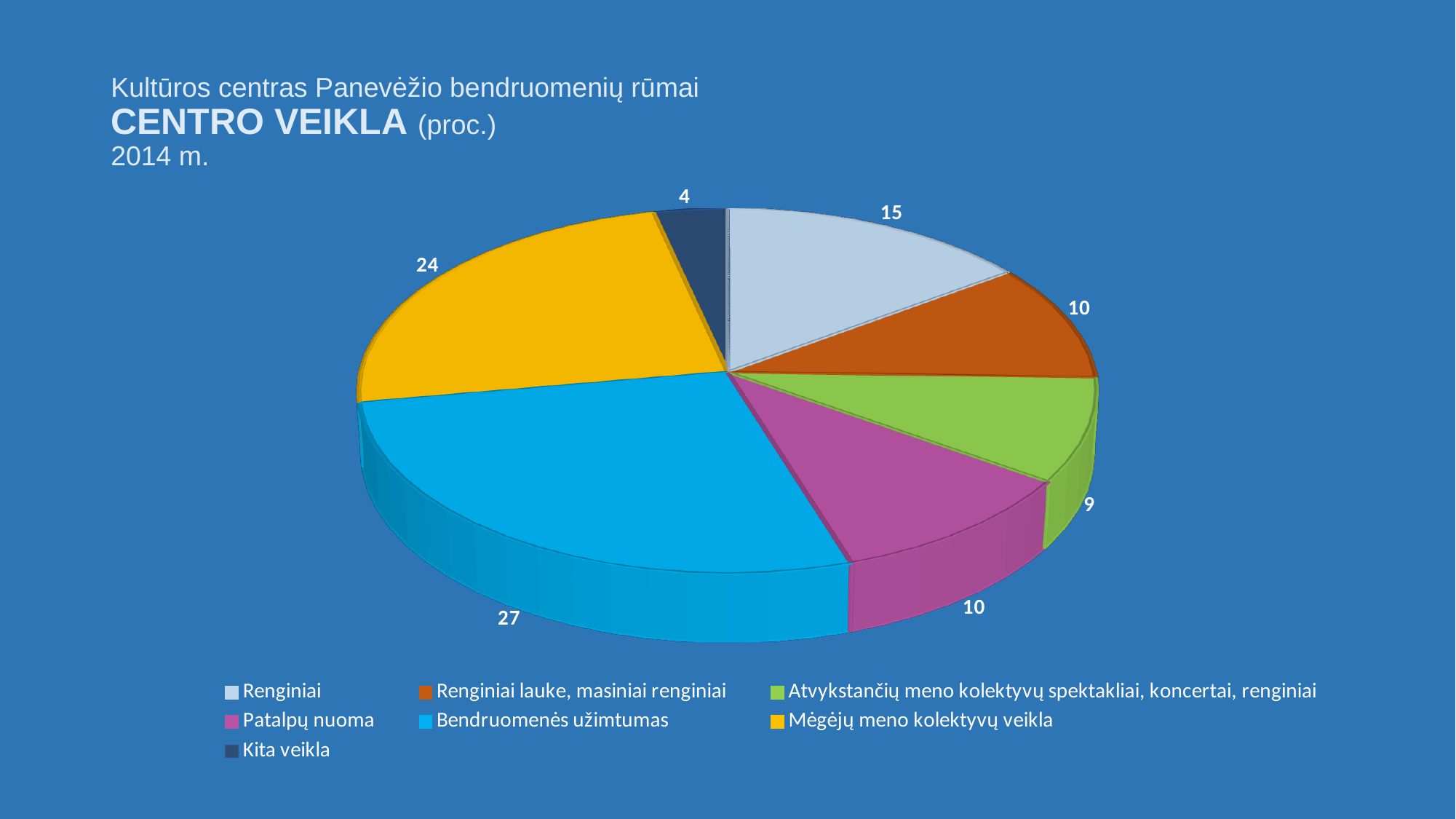
What is the value for Renginiai? 15 What is the value for Bendruomenės užimtumas? 27 Which year does the chart title refer to? 2014 m. What is the value for Atvykstančių meno kolektyvų spektakliai, koncertai, renginiai? 9 Which category has the smallest slice of the pie? Kita veikla What is the value for Mėgėjų meno kolektyvų veikla? 24 How many categories does the pie chart have? 7 What is the difference between the values for Bendruomenės užimtumas and Mėgėjų meno kolektyvų veikla? 3 Which is larger, the value for Renginiai or the value for Patalpų nuoma? Renginiai What kind of chart is shown on the slide? pie chart What is the value for Kita veikla? 4 Which category has the largest slice of the pie? Bendruomenės užimtumas